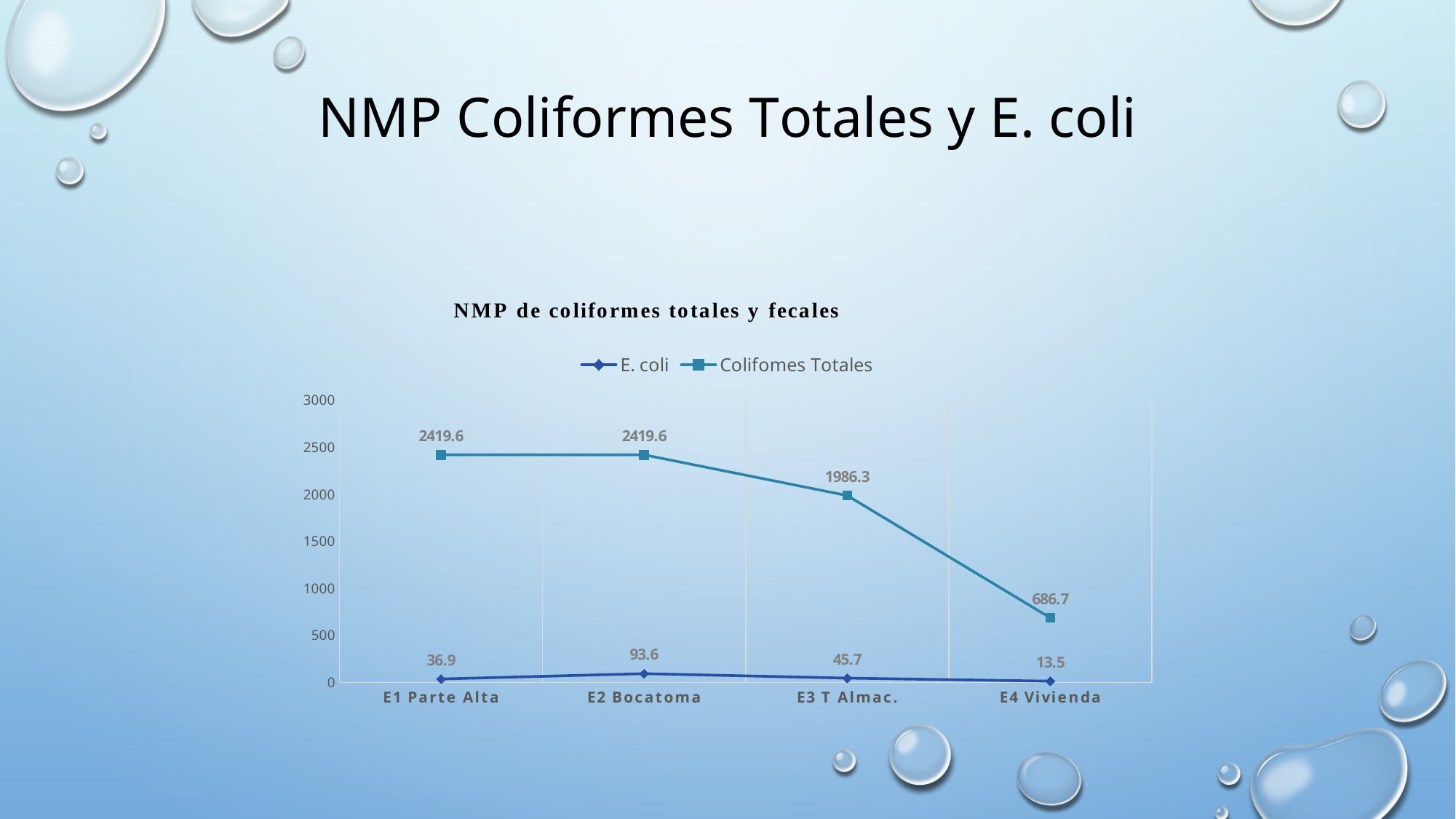
What is the value of E. coli at E2 Bocatoma? 93.6 What is the value of Colifomes Totales at E4 Vivienda? 686.7 How many categories are shown on the x axis? 4 Is the Colifomes Totales value at E3 T Almac. greater or less than 1500? greater How many series does the legend list? 2 What kind of chart is shown on the slide? line chart At which category is the Colifomes Totales value lowest? E4 Vivienda Which is larger, the E. coli value at E1 Parte Alta or at E3 T Almac.? E3 T Almac. At which category is the E. coli value highest? E2 Bocatoma What is the difference between the Colifomes Totales values at E2 Bocatoma and E3 T Almac.? 433.3 Does the Colifomes Totales series rise or fall from E2 Bocatoma to E4 Vivienda? fall What is the value of Colifomes Totales at E3 T Almac.? 1986.3